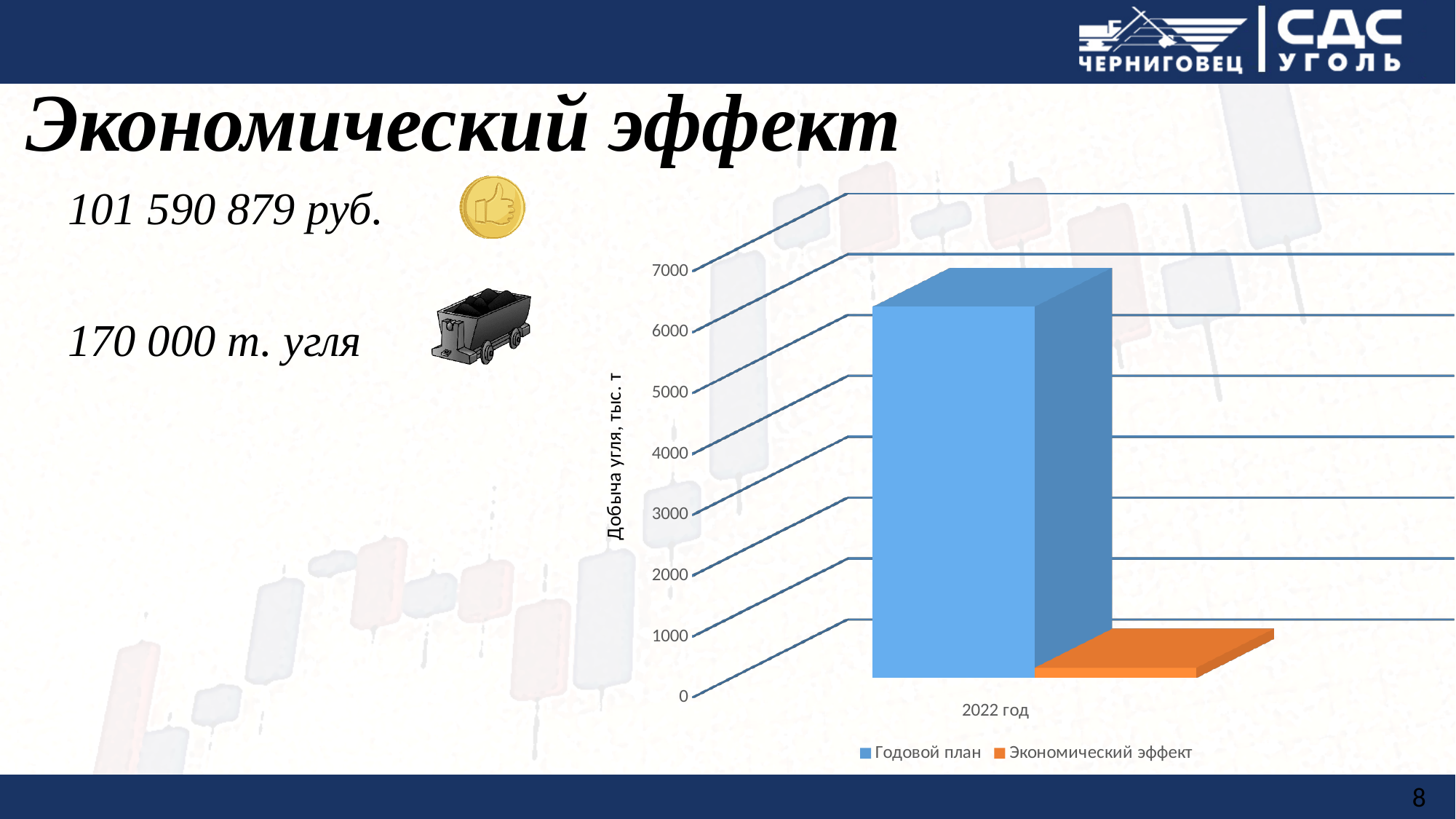
Is the value for Экономический эффект in 2022 год greater or less than 1000? less Is the value for Годовой план in 2022 год greater or less than 5000? greater Which series has the larger value for 2022 год: Годовой план or Экономический эффект? Годовой план Is the value for Годовой план in 2022 год greater or less than 7000? less How many series does the chart legend list? 2 What is the category label on the x axis of the chart? 2022 год Which series is the lowest in the chart? Экономический эффект What kind of chart is shown on the slide? bar chart Which series is the highest in the chart? Годовой план How many categories are shown on the x axis of the chart? 1 What is the title of the vertical axis of the chart? Добыча угля, тыс. т